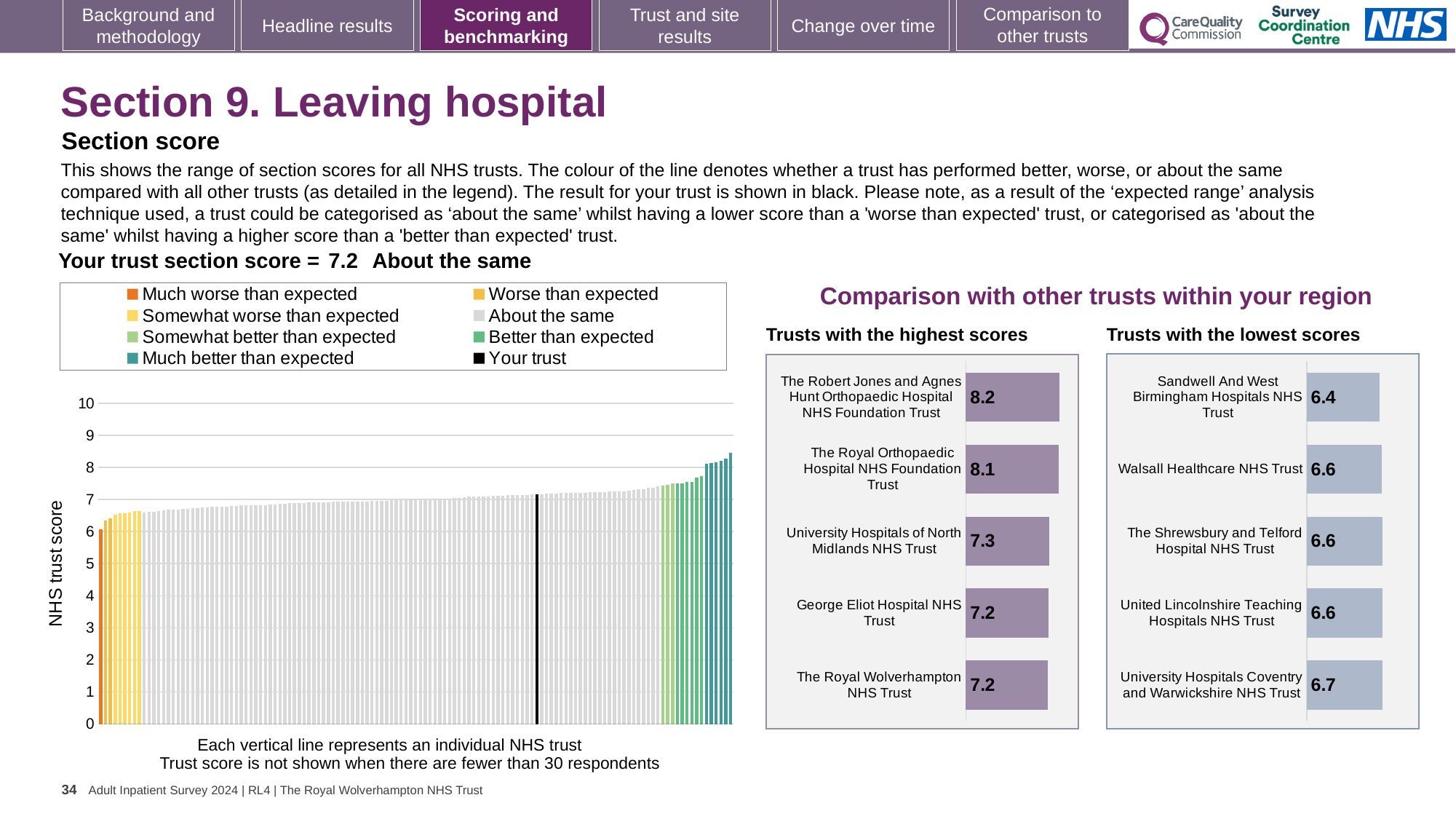
In the 'Trusts with the lowest scores' chart, what is the score for Sandwell And West Birmingham Hospitals NHS Trust? 6.4 In the 'Trusts with the highest scores' chart, what is the score for University Hospitals of North Midlands NHS Trust? 7.3 What kind of chart is the large chart on the left showing NHS trust scores? Bar chart In the 'Trusts with the lowest scores' chart, what is the score for University Hospitals Coventry and Warwickshire NHS Trust? 6.7 In the 'Trusts with the highest scores' chart, what is the difference between the scores of The Robert Jones and Agnes Hunt Orthopaedic Hospital NHS Foundation Trust and The Royal Orthopaedic Hospital NHS Foundation Trust? 0.1 In the 'Trusts with the lowest scores' chart, what is the difference between the scores of University Hospitals Coventry and Warwickshire NHS Trust and Sandwell And West Birmingham Hospitals NHS Trust? 0.3 In the 'Trusts with the highest scores' chart, how many trusts are shown? 5 Which is larger: the score for Walsall Healthcare NHS Trust in the 'Trusts with the lowest scores' chart or the score for George Eliot Hospital NHS Trust in the 'Trusts with the highest scores' chart? George Eliot Hospital NHS Trust In the 'Trusts with the highest scores' chart, which trust has the highest score? The Robert Jones and Agnes Hunt Orthopaedic Hospital NHS Foundation Trust In the 'Trusts with the highest scores' chart, what is the score for The Robert Jones and Agnes Hunt Orthopaedic Hospital NHS Foundation Trust? 8.2 In the 'Trusts with the lowest scores' chart, which trust has the lowest score? Sandwell And West Birmingham Hospitals NHS Trust How many entries does the legend of the large chart on the left list? 8